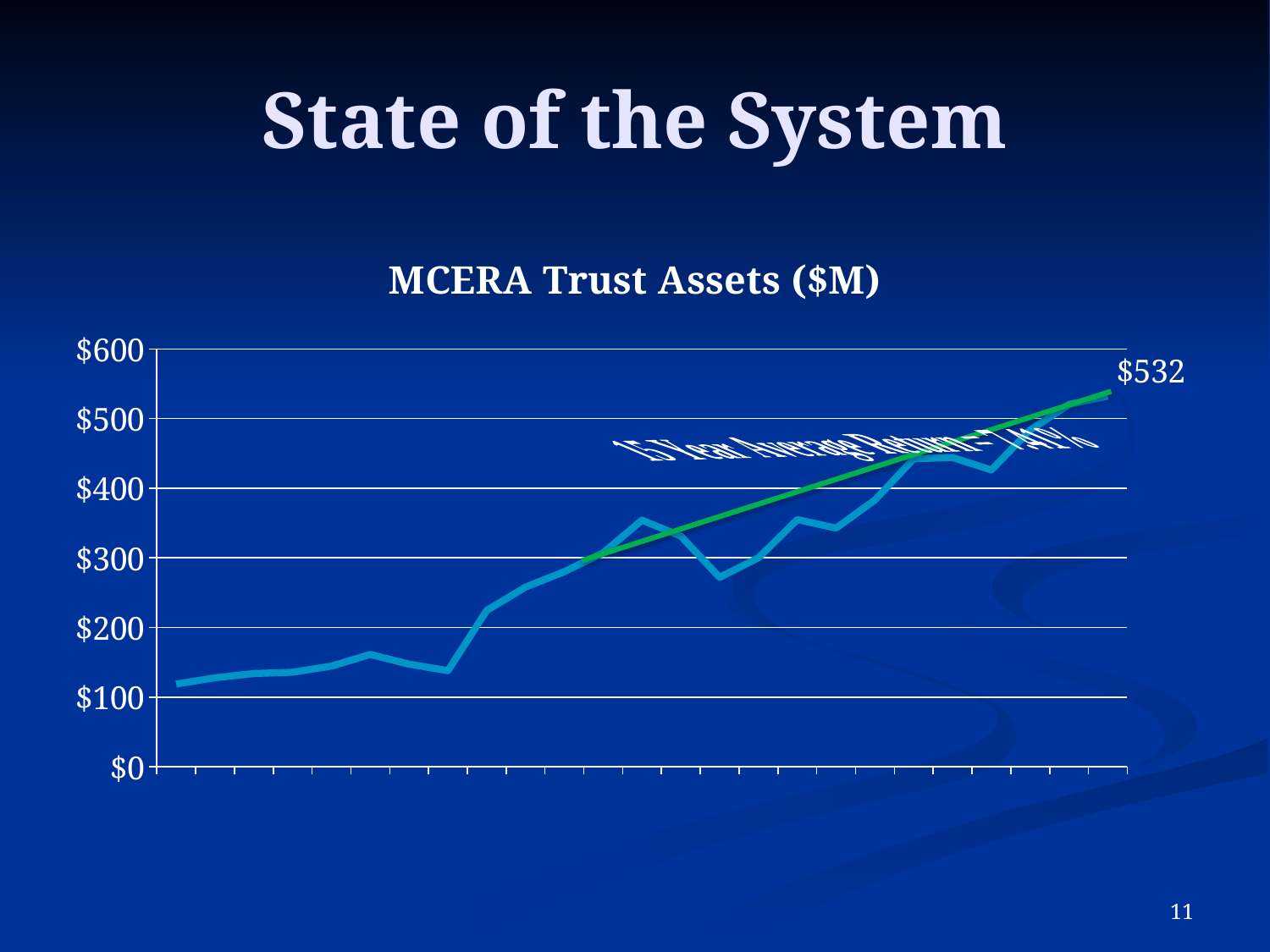
Is the highest point of the line at the start or at the end of the series? at the end What value is labelled at the right-hand end of the line? $532 Is the highest value on the line greater or less than $600? less Is the value at the left-hand start of the line greater or less than $200? less What is the title of the chart? MCERA Trust Assets ($M) What kind of chart is shown on the slide? line chart Do the trust asset values generally rise or fall from left to right along the x axis? rise Is the lowest point of the line at the start or at the end of the series? at the start Is the lowest value on the line greater or less than $200? less Which is larger, the value at the start of the line or the value at the end of the line? the value at the end What is the highest value shown on the y axis? $600